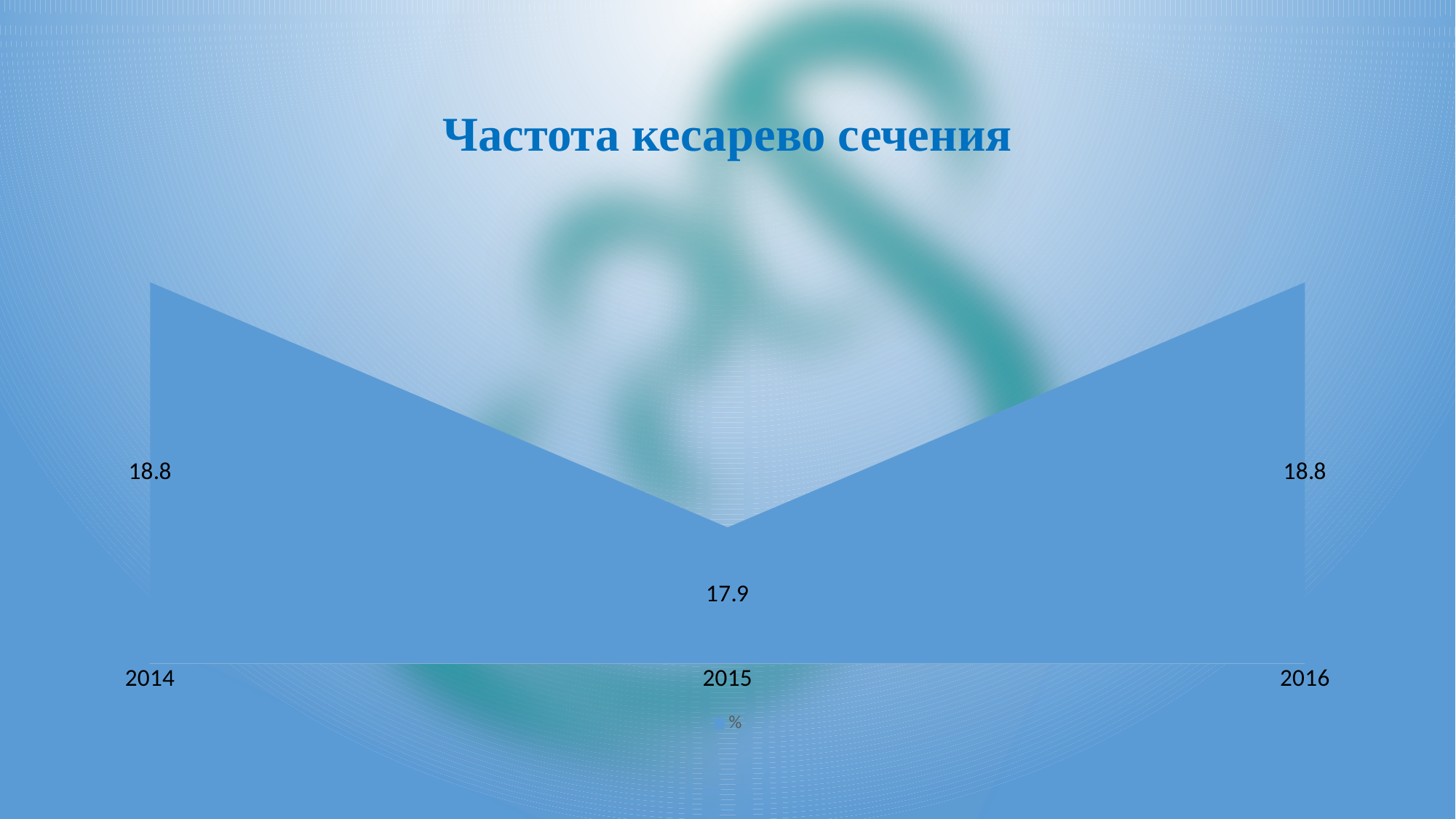
What is the difference between the values for 2014 and 2015? 0.9 What kind of chart is shown on the slide? Area chart What is the value for 2016? 18.8 Which year has the lowest value? 2015 How many series does the legend list? 1 Does the value rise or fall from 2014 to 2015? Fall What is the title of the chart? Частота кесарево сечения What is the value for 2014? 18.8 How many years are shown on the x axis? 3 What is the value for 2015? 17.9 What is the legend entry for the series? % Which is larger, the value for 2015 or the value for 2016? 2016